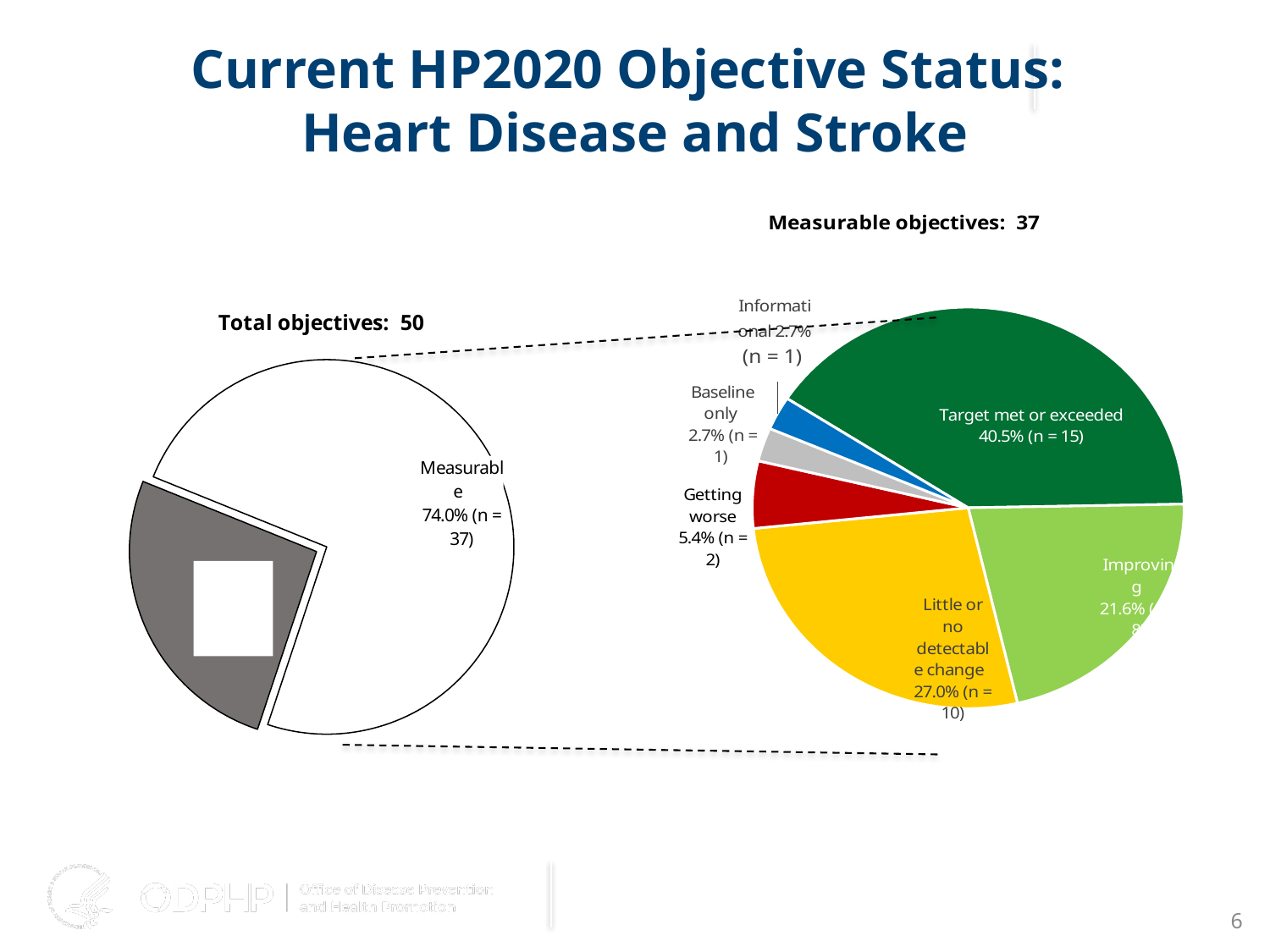
In the 'Measurable objectives: 37' pie chart, which status category has the largest share? Target met or exceeded In the 'Measurable objectives: 37' pie chart, what percentage of objectives have the target met or exceeded? 40.5% In the 'Measurable objectives: 37' pie chart, what percentage of objectives are improving? 21.6% In the 'Measurable objectives: 37' pie chart, how many objectives are getting worse? 2 In the 'Measurable objectives: 37' pie chart, what percentage of objectives show little or no detectable change? 27.0% In the 'Measurable objectives: 37' pie chart, how many objectives have the target met or exceeded? 15 In the 'Measurable objectives: 37' pie chart, which is larger: the share for 'Little or no detectable change' or the share for 'Improving'? Little or no detectable change In the 'Measurable objectives: 37' pie chart, what is the difference in percentage points between 'Target met or exceeded' and 'Getting worse'? 35.1 percentage points In the 'Total objectives: 50' pie chart, how many objectives are measurable? 37 In the 'Total objectives: 50' pie chart, what percentage of objectives are measurable? 74.0% What kind of chart is used on the right side of the slide for the measurable objectives? pie chart In the 'Measurable objectives: 37' pie chart, how many status categories are shown? 6